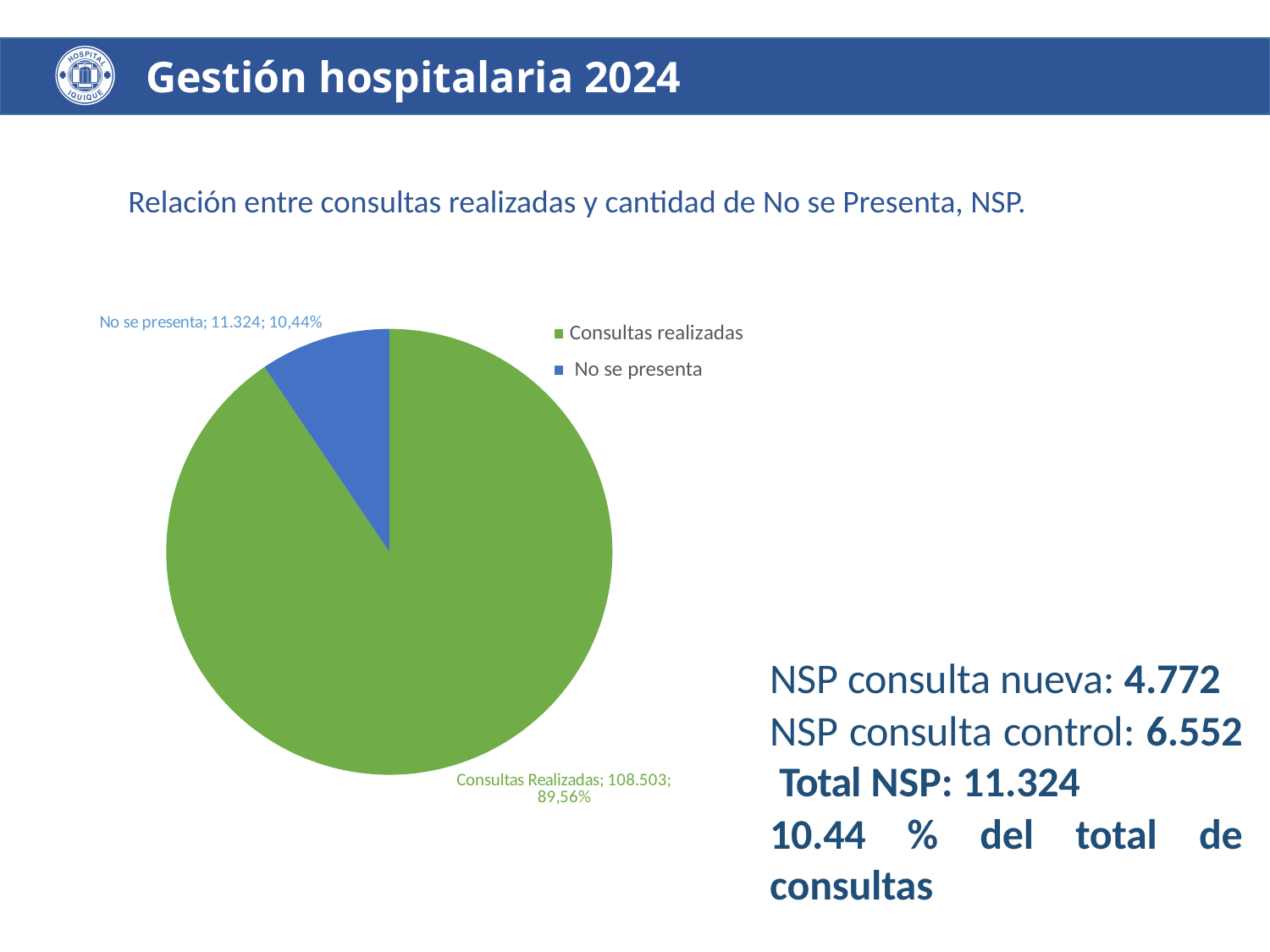
How many entries does the legend list? 2 Which slice of the pie is the largest? Consultas Realizadas How many slices does the pie chart have? 2 What colour is the No se presenta slice? blue Which is larger, Consultas Realizadas or No se presenta? Consultas Realizadas Which slice of the pie is the smallest? No se presenta What is the value shown for the Consultas Realizadas slice? 108.503 What percentage share of the pie does the Consultas Realizadas slice represent? 89,56% What is the difference between the Consultas Realizadas value and the No se presenta value? 97.179 What is the value shown for the No se presenta slice? 11.324 What percentage share of the pie does the No se presenta slice represent? 10,44% What kind of chart is shown on the slide? pie chart